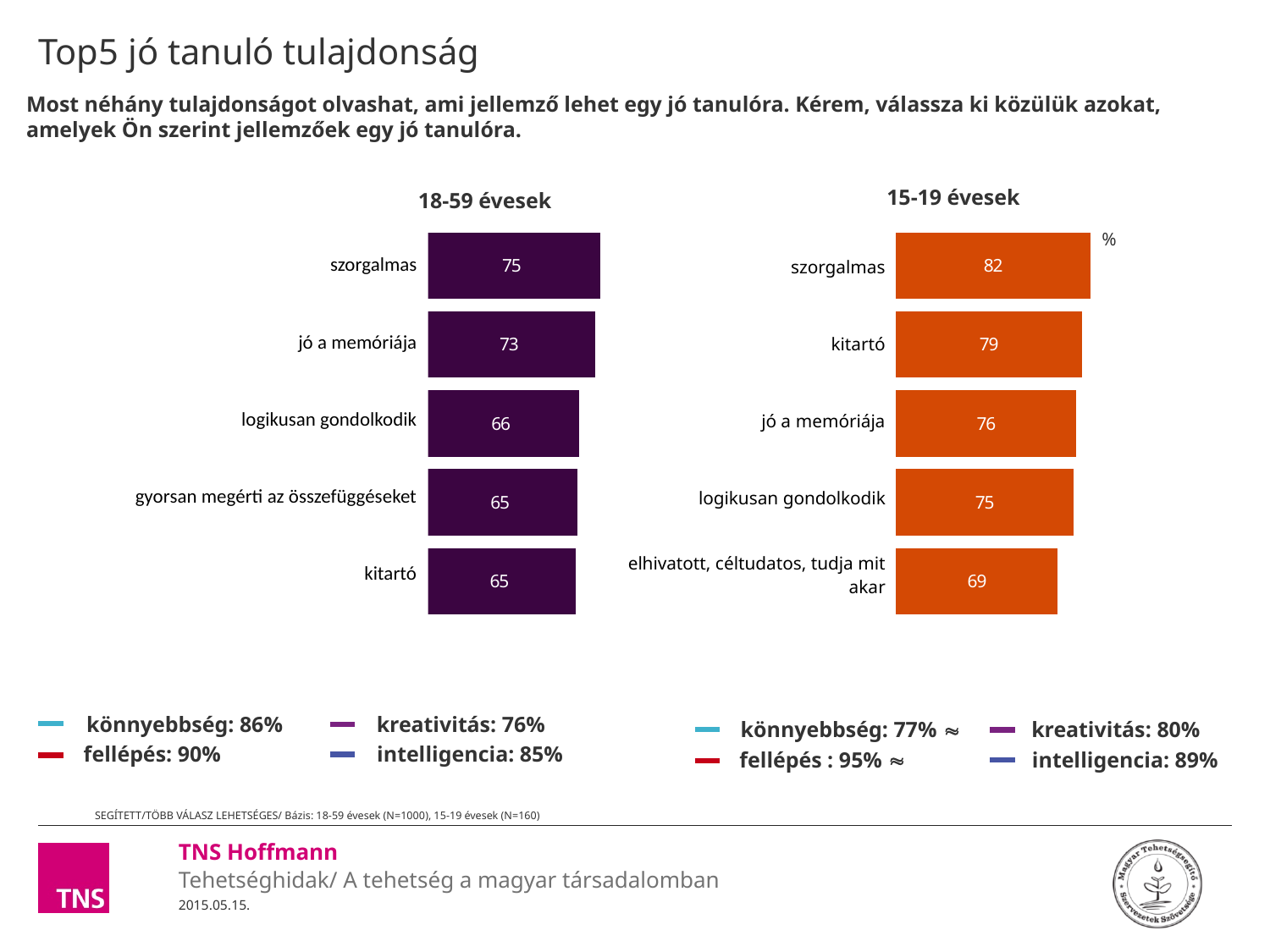
What colour are the bars in the "15-19 évesek" chart? orange What type of chart is the "18-59 évesek" chart? bar chart In the "15-19 évesek" chart, what is the value for "kitartó"? 79 In the "18-59 évesek" chart, which category has the highest value? szorgalmas In the "18-59 évesek" chart, what is the difference between "jó a memóriája" and "logikusan gondolkodik"? 7 In the "18-59 évesek" chart, what is the value for "szorgalmas"? 75 In the "15-19 évesek" chart, what is the value for "logikusan gondolkodik"? 75 In the "18-59 évesek" chart, how many categories are shown? 5 In the "15-19 évesek" chart, which category has the lowest value? elhivatott, céltudatos, tudja mit akar Which is larger: "kitartó" in the "18-59 évesek" chart or "kitartó" in the "15-19 évesek" chart? 15-19 évesek In the "15-19 évesek" chart, how many categories are shown? 5 In the "15-19 évesek" chart, what is the difference between "szorgalmas" and "jó a memóriája"? 6